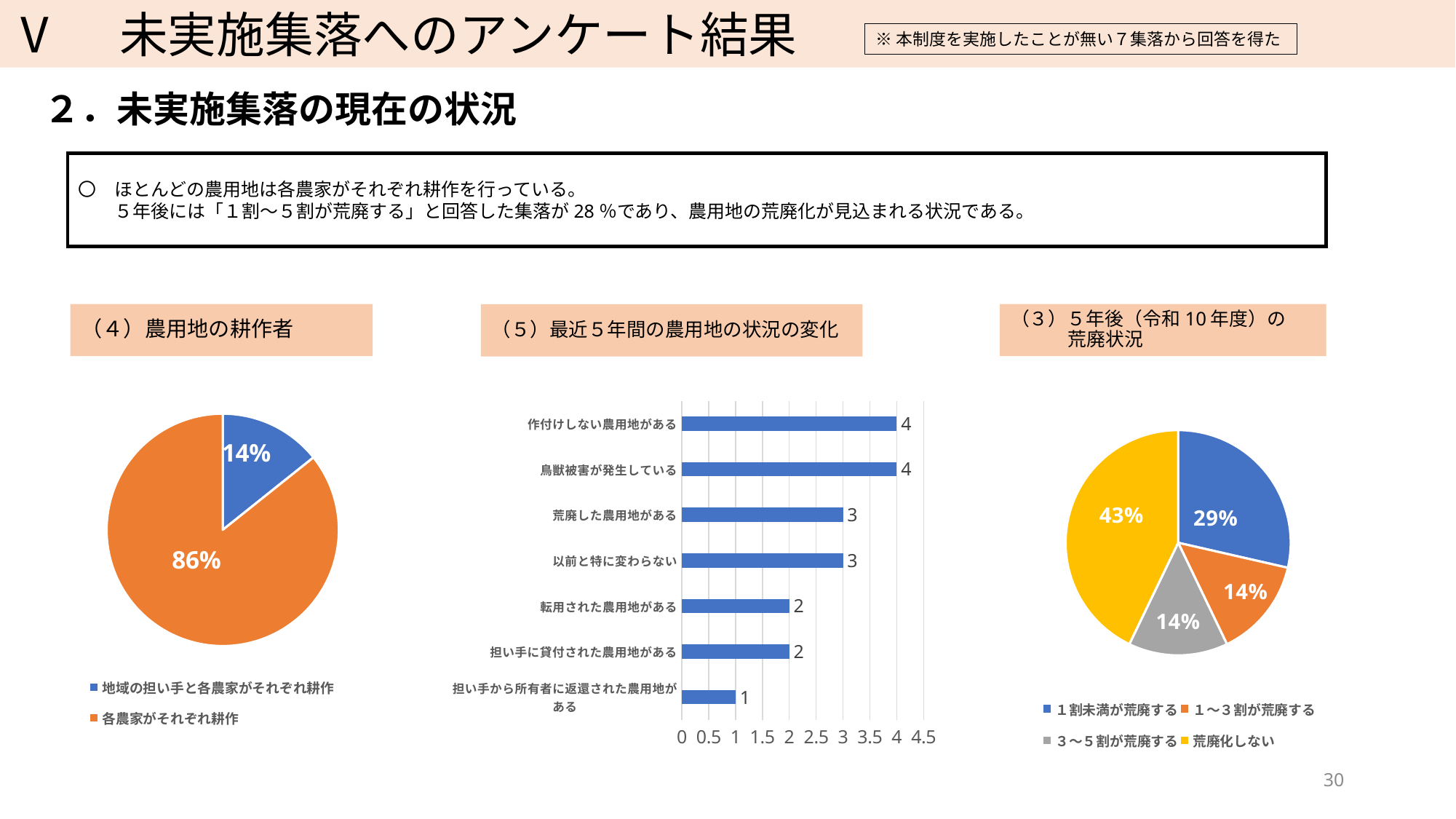
In the chart titled （５）最近５年間の農用地の状況の変化, which category has the lowest value? 担い手から所有者に返還された農用地がある In the chart titled （５）最近５年間の農用地の状況の変化, what is the value for 荒廃した農用地がある? 3 In the chart titled （４）農用地の耕作者, what share of the pie is 各農家がそれぞれ耕作? 86% In the chart titled （５）最近５年間の農用地の状況の変化, what is the difference between 作付けしない農用地がある and 転用された農用地がある? 2 What kind of chart is the chart titled （４）農用地の耕作者? pie chart In the chart titled （３）５年後（令和10年度）の荒廃状況, what share of the pie is 荒廃化しない? 43% What kind of chart is the chart titled （５）最近５年間の農用地の状況の変化? bar chart In the chart titled （４）農用地の耕作者, what is the value for 地域の担い手と各農家がそれぞれ耕作? 14% In the chart titled （３）５年後（令和10年度）の荒廃状況, which category has the largest share? 荒廃化しない In the chart titled （５）最近５年間の農用地の状況の変化, what is the value for 担い手から所有者に返還された農用地がある? 1 In the chart titled （３）５年後（令和10年度）の荒廃状況, how many entries does the legend list? 4 In the chart titled （５）最近５年間の農用地の状況の変化, how many categories are shown? 7